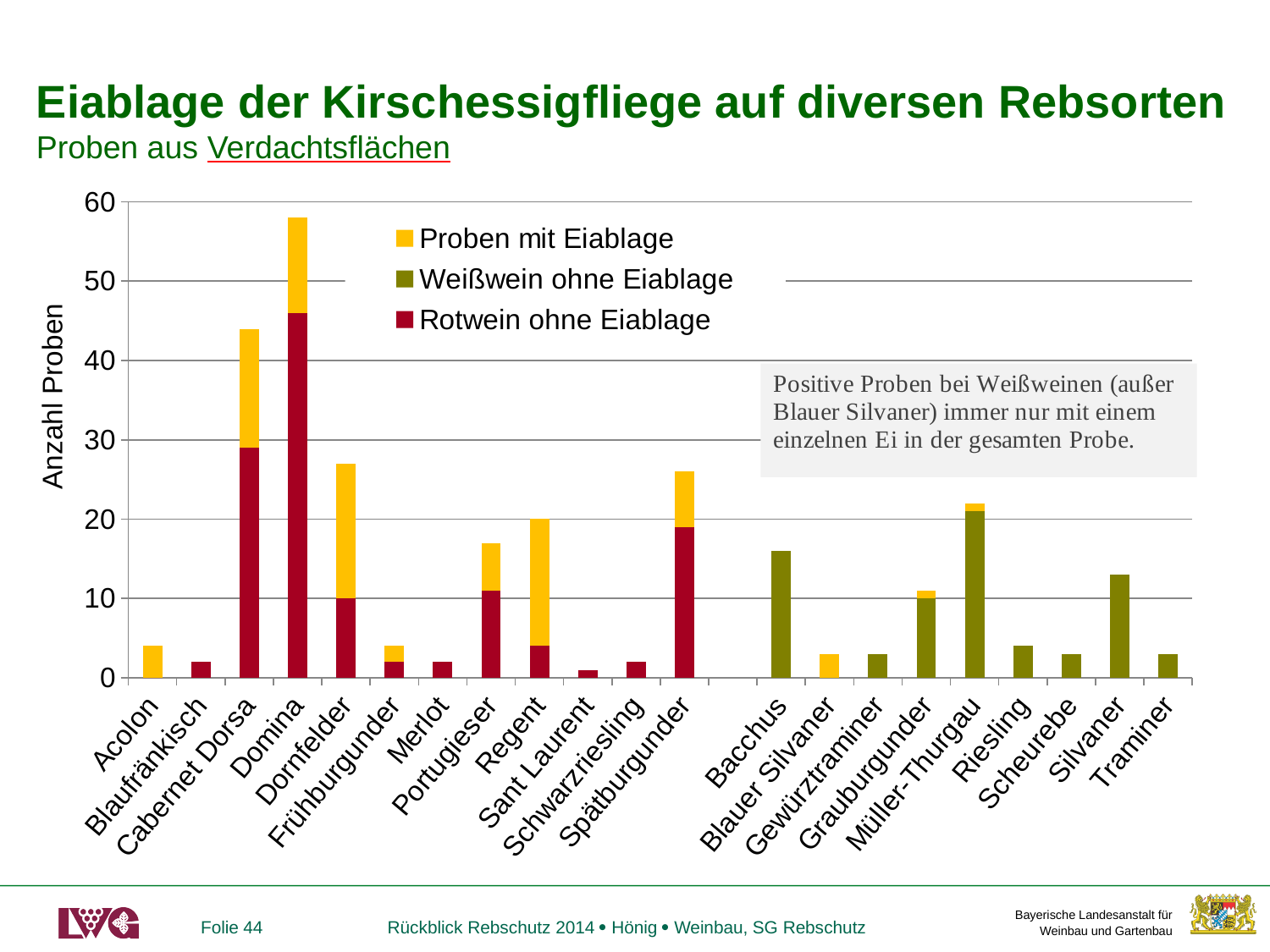
Is the total value for Spätburgunder greater or less than 20? greater What kind of chart is shown on the slide? stacked bar chart Which has more samples in total, Bacchus or Silvaner? Bacchus How many grape varieties (categories) are shown on the x axis? 21 Is the total value for Domina greater or less than 50? greater Is the value for Bacchus greater or less than 20? less What is the label of the y axis? Anzahl Proben Which has more samples in total, Cabernet Dorsa or Dornfelder? Cabernet Dorsa How many series does the legend list? 3 Which grape variety has the lowest total number of samples? Sant Laurent Which grape variety has the highest total number of samples? Domina